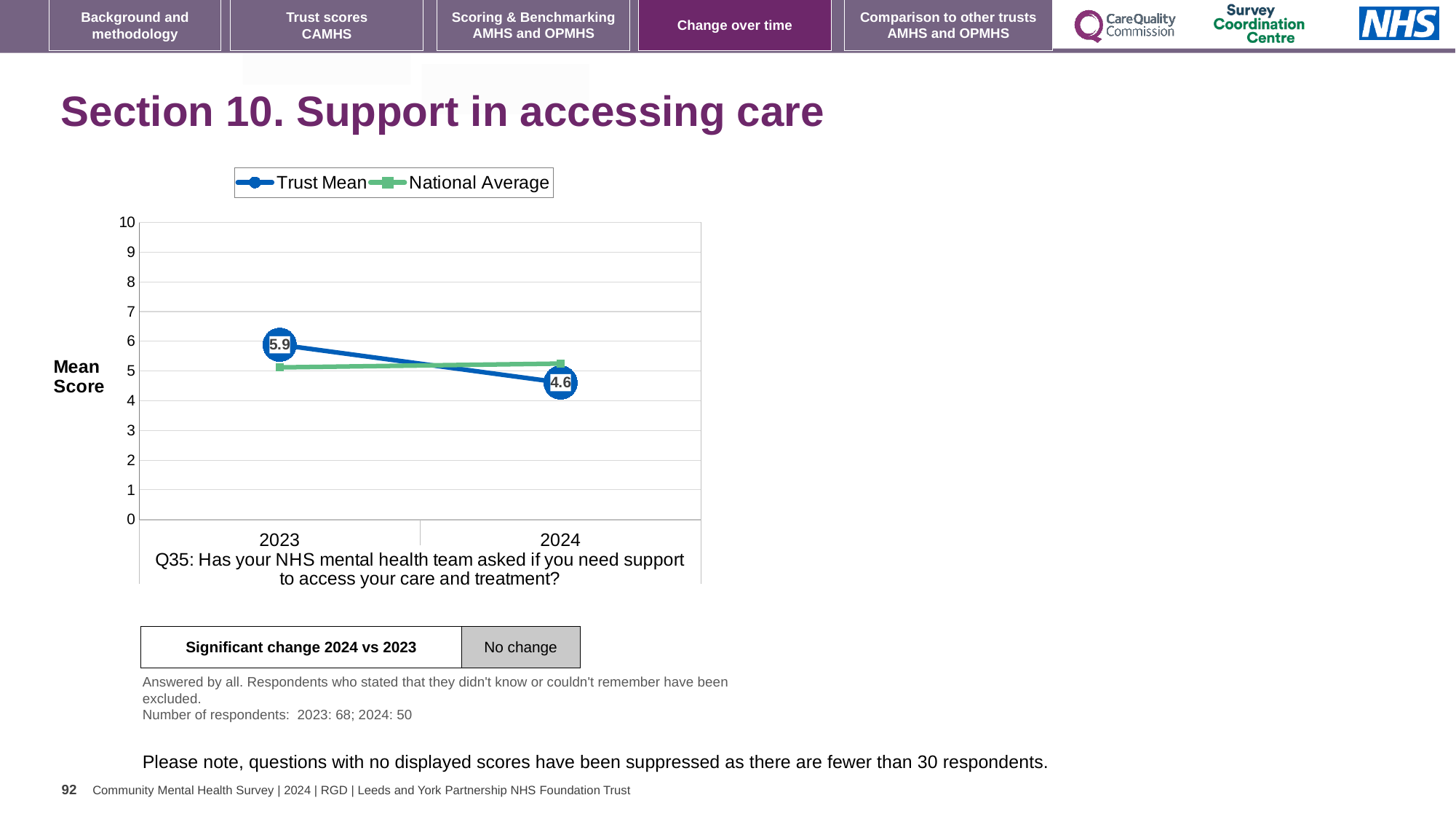
What is the Trust Mean value for 2023? 5.9 In 2023, which series has the higher value, Trust Mean or National Average? Trust Mean How many years are shown on the x axis of the chart? 2 In 2024, which series has the higher value, Trust Mean or National Average? National Average In which year is the Trust Mean higher, 2023 or 2024? 2023 What is the Trust Mean value for 2024? 4.6 Does the Trust Mean rise or fall from 2023 to 2024? fall How many series does the chart legend list? 2 Is the National Average value for 2024 greater or less than 4? greater Is the National Average value for 2023 greater or less than 6? less What kind of chart is shown on the slide? line chart By how much did the Trust Mean change from 2023 to 2024? 1.3